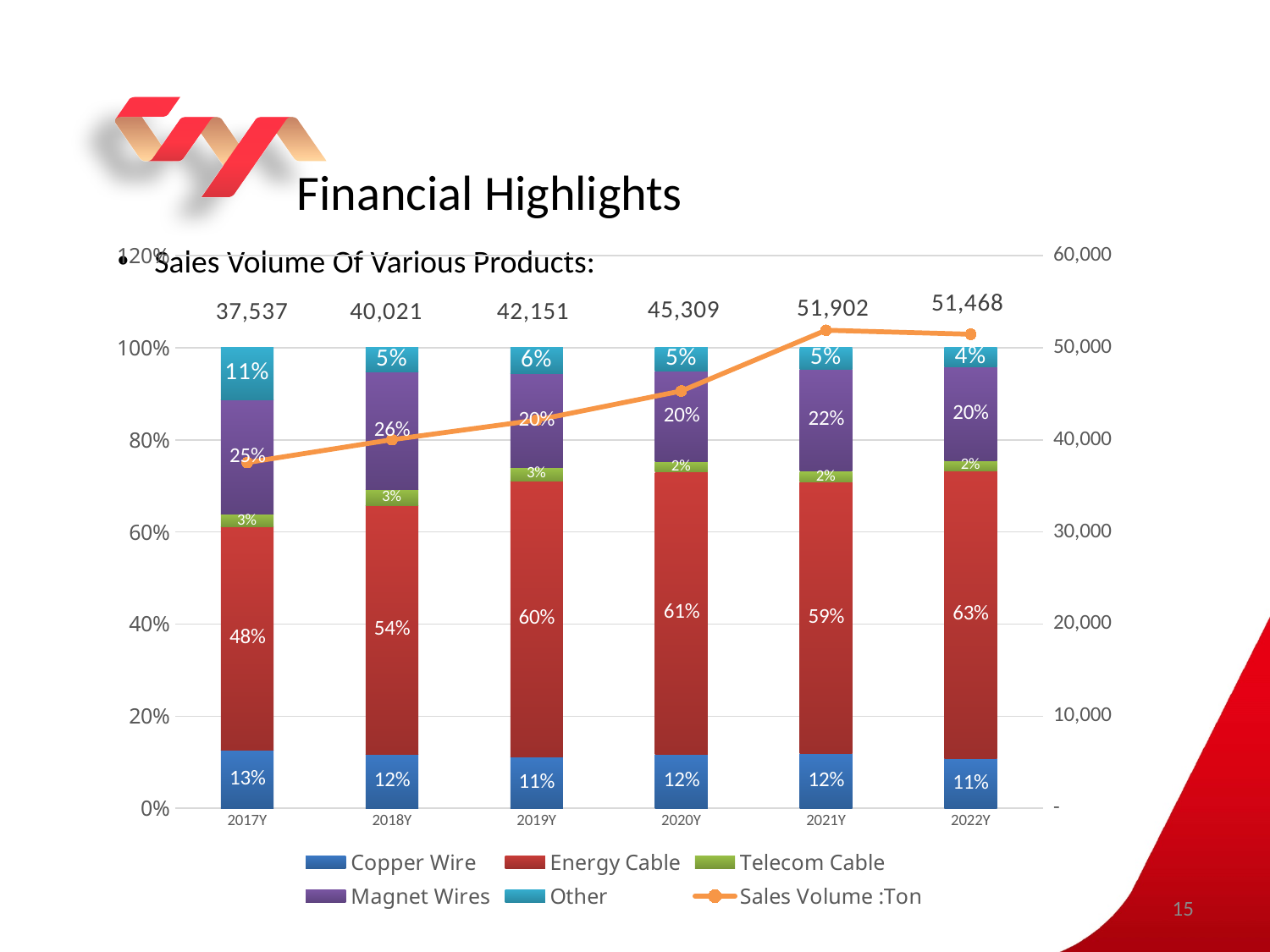
How many series does the legend list? 6 What is the Other share in 2017Y? 11% What percentage share does Energy Cable have in 2019Y? 60% What is the Sales Volume (Ton) for 2021Y? 51,902 Which year has the lowest Sales Volume? 2017Y Which year has the highest Sales Volume? 2021Y What is the Magnet Wires share in 2021Y? 22% How many years are shown on the x axis? 6 Which year has the larger Energy Cable share, 2018Y or 2022Y? 2022Y By how much did Sales Volume in 2022Y exceed Sales Volume in 2017Y? 13,931 What kind of chart is shown on the slide? Stacked bar chart with a line Does the Sales Volume line rise or fall from 2017Y to 2021Y? Rise